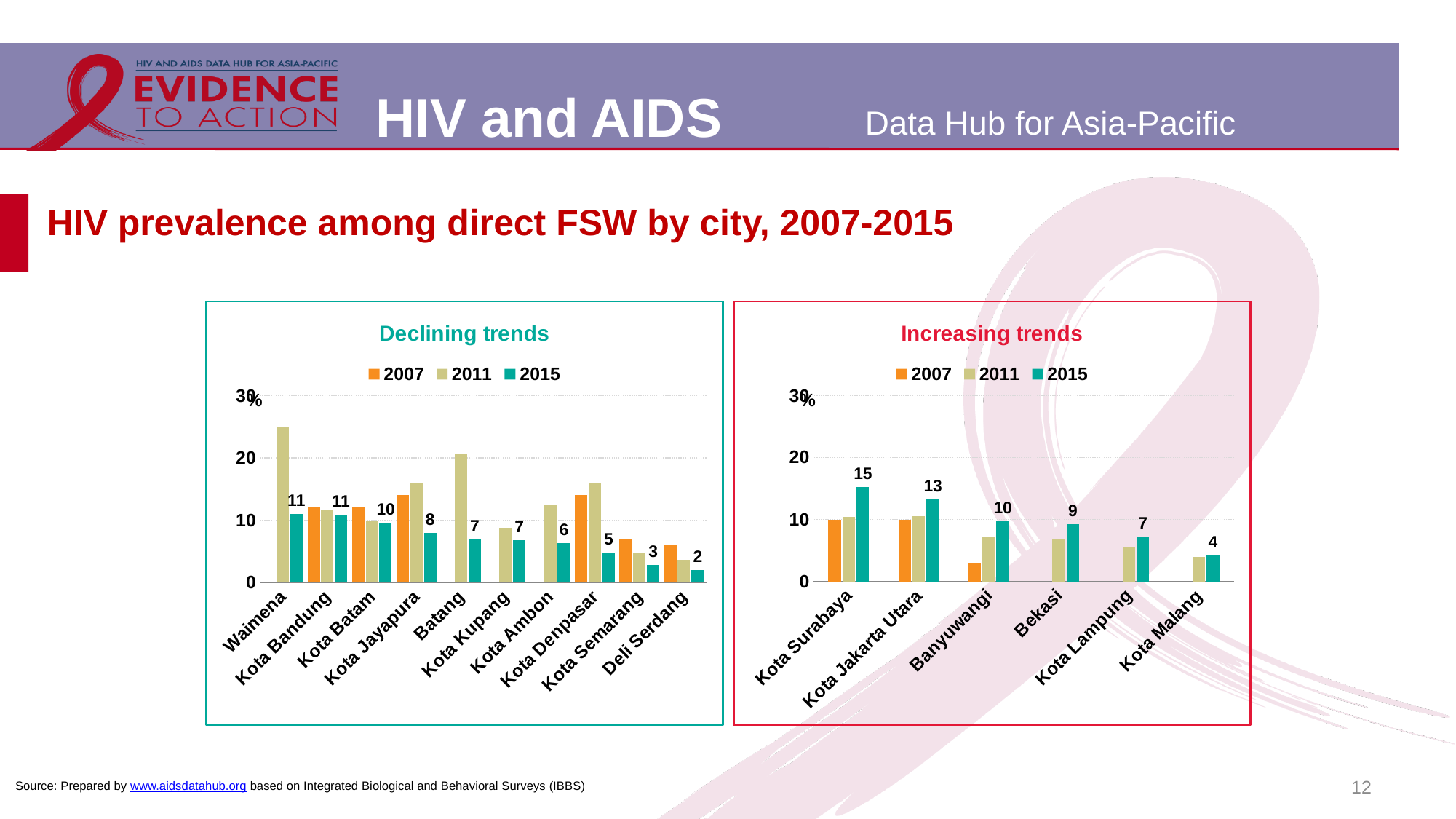
What kind of chart is the Increasing trends chart? bar chart In the Increasing trends chart, is the 2007 value for Banyuwangi greater or less than 10? less In the Declining trends chart, which city has the lowest 2015 value? Deli Serdang In the Increasing trends chart, what is the 2015 value for Kota Jakarta Utara? 13 How many cities are shown in the Increasing trends chart? 6 In the Declining trends chart, which is larger in 2015: Kota Batam or Kota Semarang? Kota Batam In the Declining trends chart, what is the 2015 value for Kota Jayapura? 8 In the Declining trends chart, is the 2011 value for Waimena greater or less than 20? greater How many series does the legend of the Declining trends chart list? 3 In the Increasing trends chart, do the 2015 values rise or fall from Kota Surabaya to Kota Malang? fall In the Increasing trends chart, which city has the highest 2015 value? Kota Surabaya In the Increasing trends chart, what is the difference between the 2015 values for Kota Surabaya and Kota Malang? 11